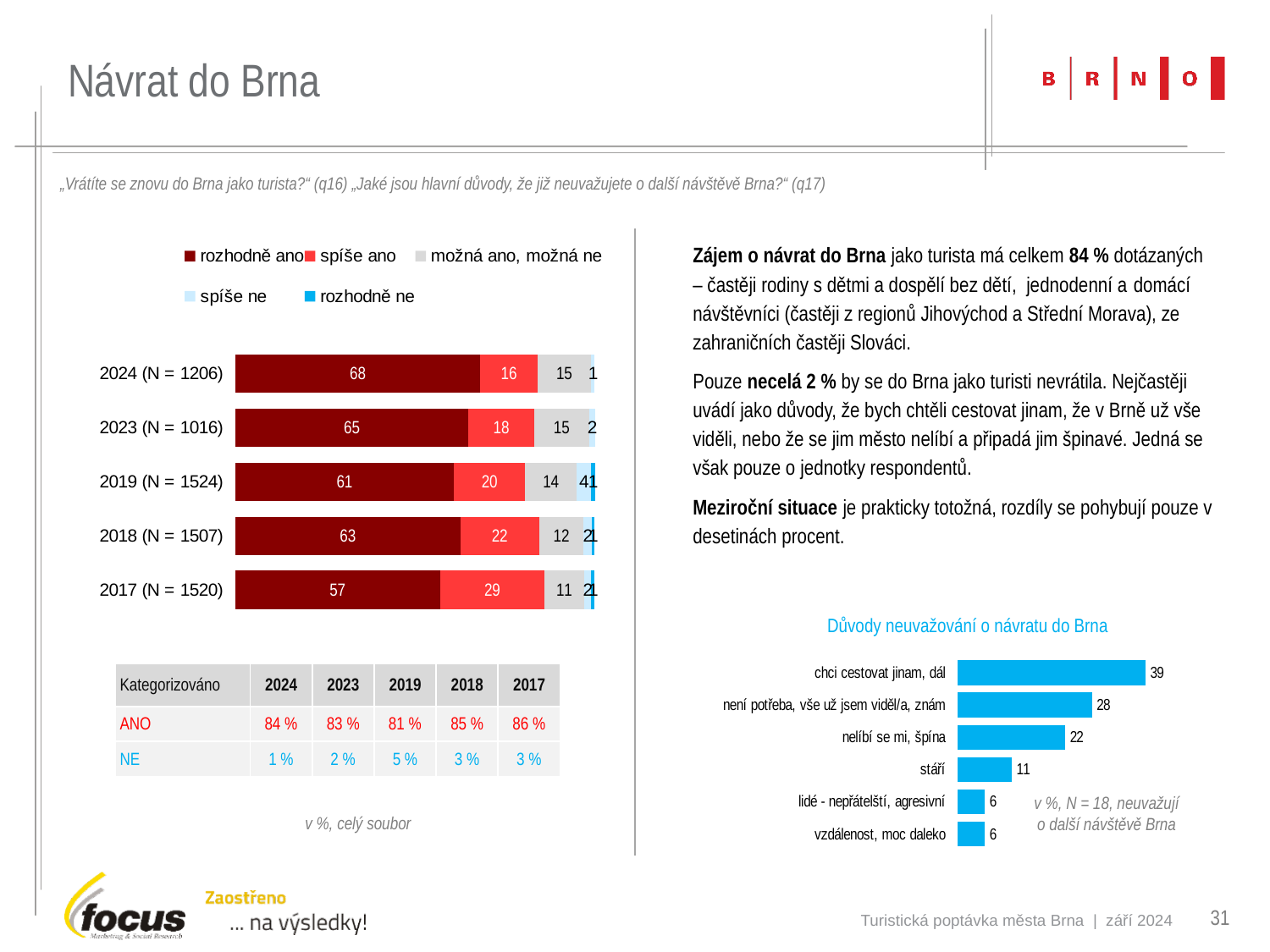
In the stacked bar chart on the left, which year has the highest value for "rozhodně ano"? 2024 (N = 1206) In the stacked bar chart on the left, what is the value for "spíše ano" in 2017 (N = 1520)? 29 In the stacked bar chart on the left, how many years are shown? 5 In the stacked bar chart on the left, how many series does the legend list? 5 In the stacked bar chart on the left, what is the difference between the "rozhodně ano" values for 2024 and 2023? 3 In the chart "Důvody neuvažování o návratu do Brna", which is larger: "nelíbí se mi, špína" or "stáří"? nelíbí se mi, špína In the stacked bar chart on the left, what is the value for "rozhodně ano" in 2024 (N = 1206)? 68 In the stacked bar chart on the left, which year has the lowest value for "rozhodně ano"? 2017 (N = 1520) In the chart "Důvody neuvažování o návratu do Brna", what is the value for "stáří"? 11 In the chart "Důvody neuvažování o návratu do Brna", what is the difference between "chci cestovat jinam, dál" and "není potřeba, vše už jsem viděl/a, znám"? 11 What kind of chart is "Důvody neuvažování o návratu do Brna"? bar chart In the chart "Důvody neuvažování o návratu do Brna", which reason has the highest value? chci cestovat jinam, dál